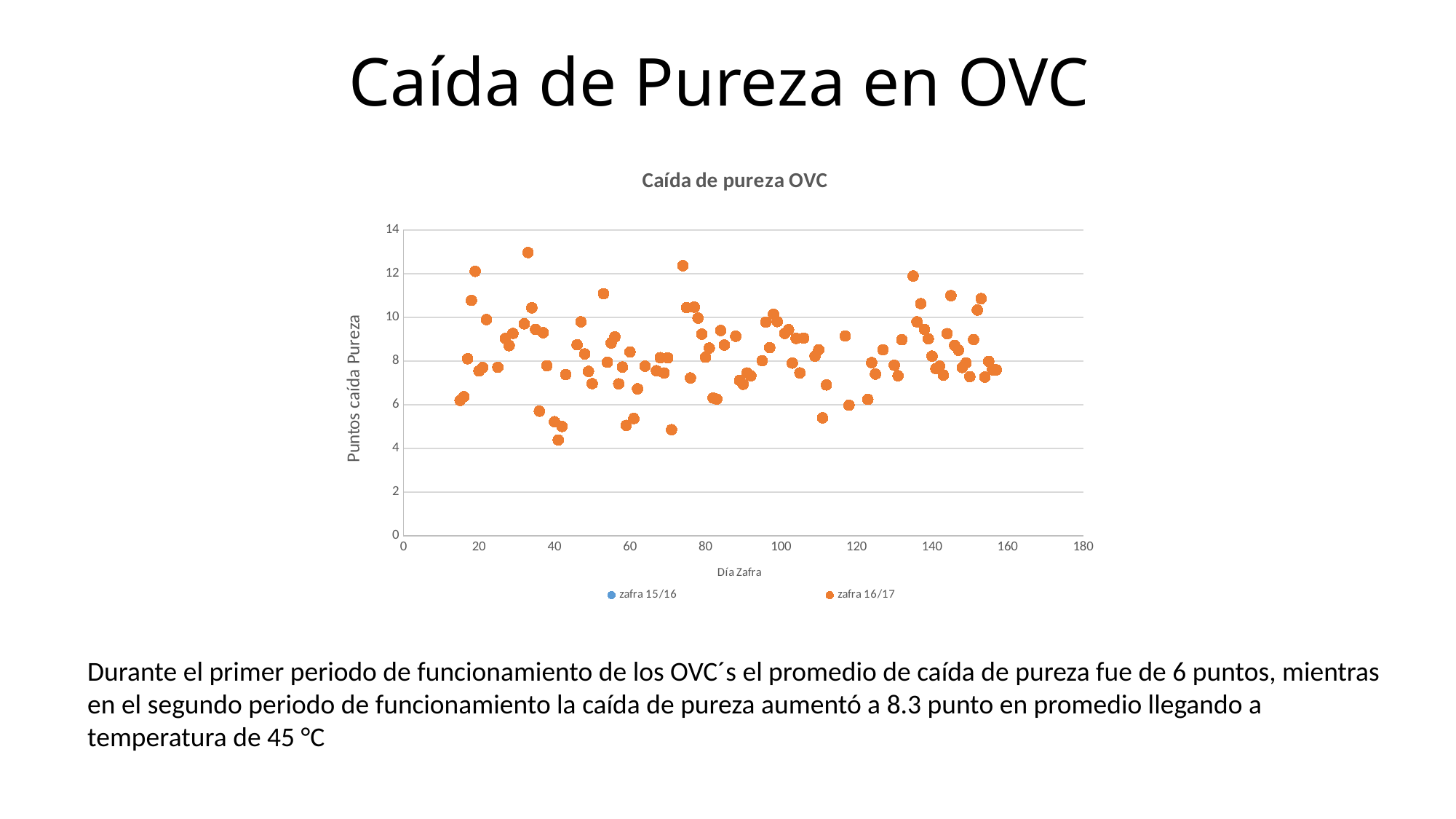
Which is larger, the value plotted at around day 33 or the value plotted at around day 41? day 33 Is the value plotted at around day 111 greater or less than 6? less What kind of chart is shown on the slide? scatter chart Is the lowest plotted value in the chart greater or less than 5? less What label is shown on the x axis of the chart? Día Zafra Is the value plotted at around day 33 greater or less than 12? greater What is the title of the chart? Caída de pureza OVC How many series does the chart legend list? 2